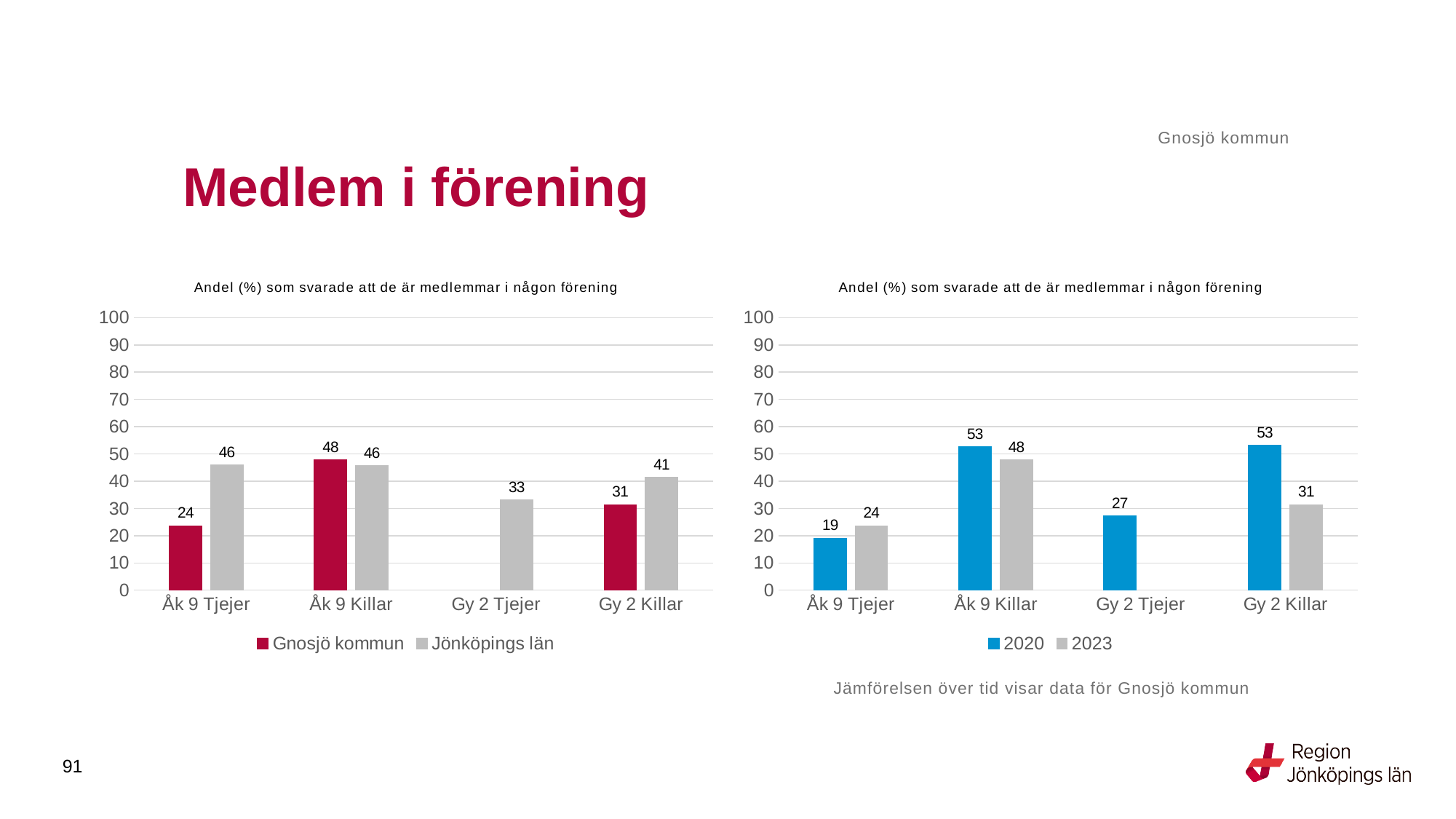
In the left chart, which category has the lowest value for Jönköpings län? Gy 2 Tjejer In the left chart, what is the difference between Jönköpings län and Gnosjö kommun for Åk 9 Tjejer? 22 In the right chart, how many categories are shown on the x axis? 4 In the right chart, what is the value for 2020 for Gy 2 Tjejer? 27 In the right chart, which is larger for Gy 2 Killar, 2020 or 2023? 2020 In the right chart, what is the value for 2023 for Åk 9 Killar? 48 In the left chart, which category has the highest value for Gnosjö kommun? Åk 9 Killar In the right chart, what is the difference between 2020 and 2023 for Gy 2 Killar? 22 In the left chart, what is the value for Gnosjö kommun for Åk 9 Tjejer? 24 What kind of chart is the right chart? Bar chart In the left chart, how many series does the legend list? 2 In the left chart, what is the value for Jönköpings län for Gy 2 Killar? 41